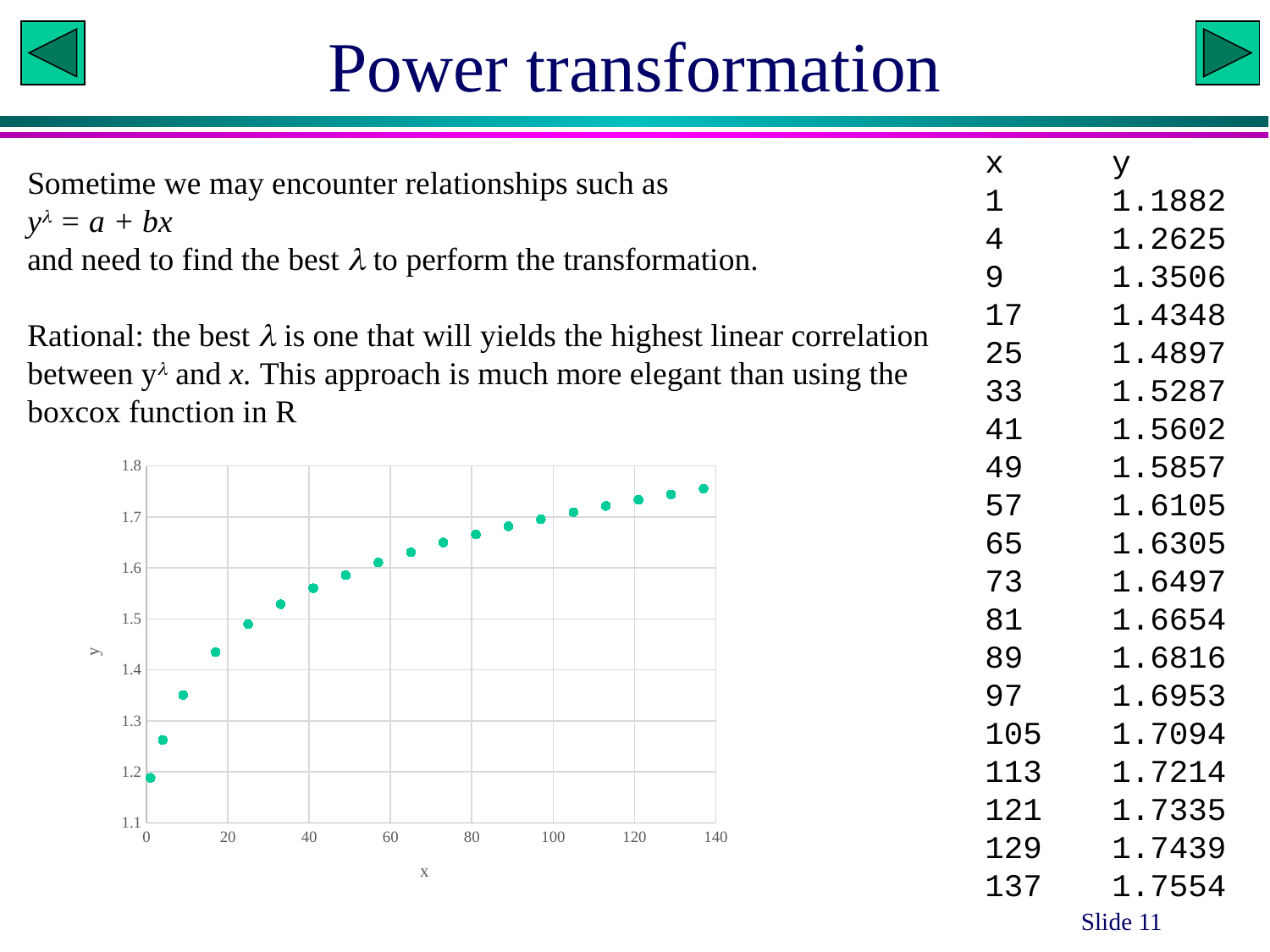
What is the y value at x = 137? 1.7554 Is the y value at x = 89 greater or less than 1.6? greater Which is larger, the y value at x = 17 or the y value at x = 65? x = 65 What is the difference between the y value at x = 137 and the y value at x = 1? 0.5672 What is the y value at x = 1? 1.1882 At which x value is y lowest? 1 What is the label on the horizontal axis of the chart? x At which x value is y highest? 137 What kind of chart is shown on the slide? scatter chart What is the y value at x = 49? 1.5857 How many data points are plotted in the chart? 19 Do the y values rise or fall as x increases along the x axis? rise